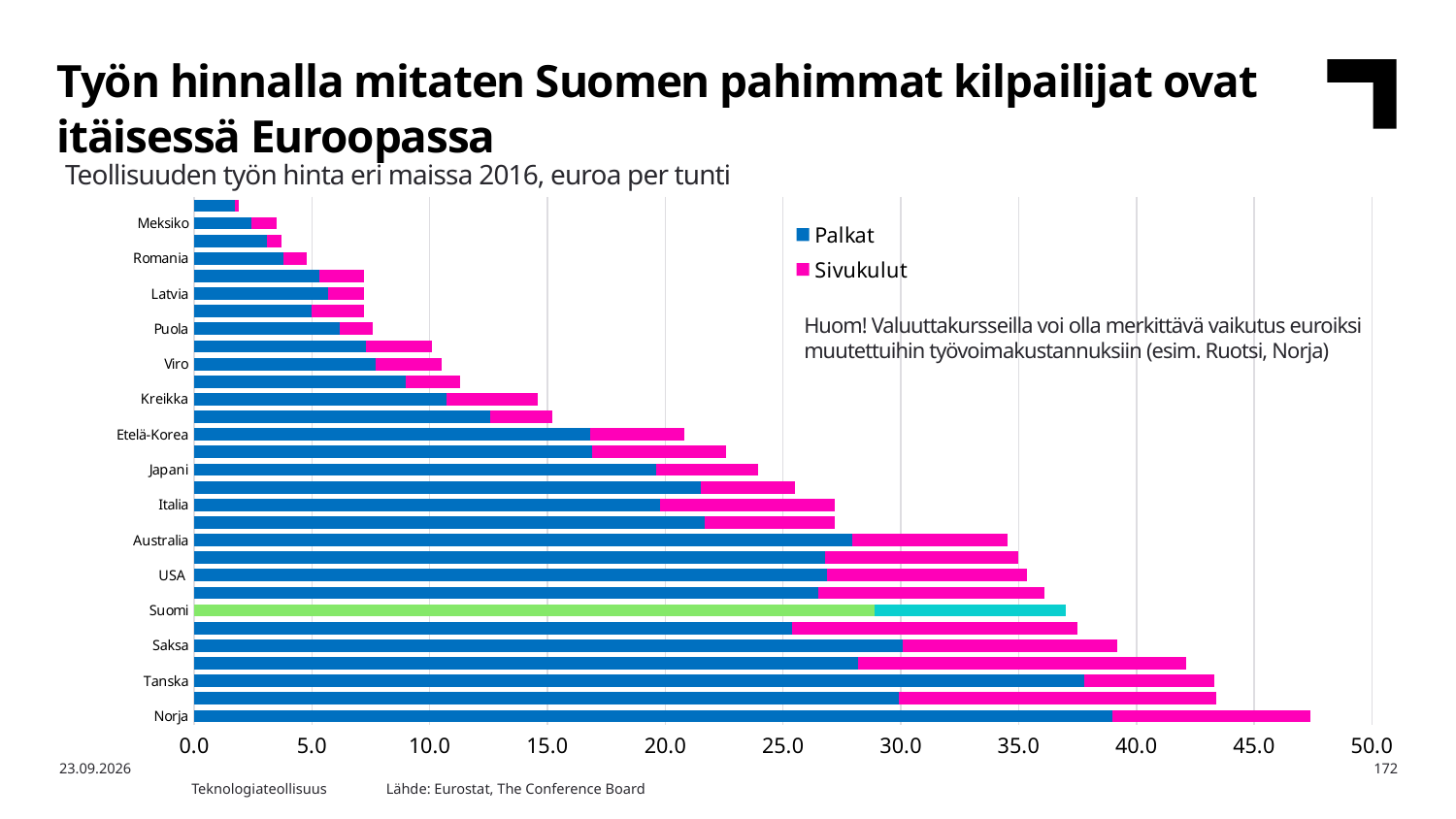
Do the total bar lengths increase or decrease going from the top of the chart to the bottom? Increase How many series does the legend list? 2 Which labelled country has the shortest total bar? Meksiko Which has the larger total bar, Tanska or Saksa? Tanska What are the two series named in the legend? Palkat and Sivukulut Is the total value for Meksiko greater or less than 5.0? less Is the total value for Norja greater or less than 45.0? greater Which has the larger total bar, Italia or Japani? Italia Is the total value for Japani greater or less than 25.0? less Which labelled country has the longest total bar? Norja What kind of chart is shown on the slide? Bar chart